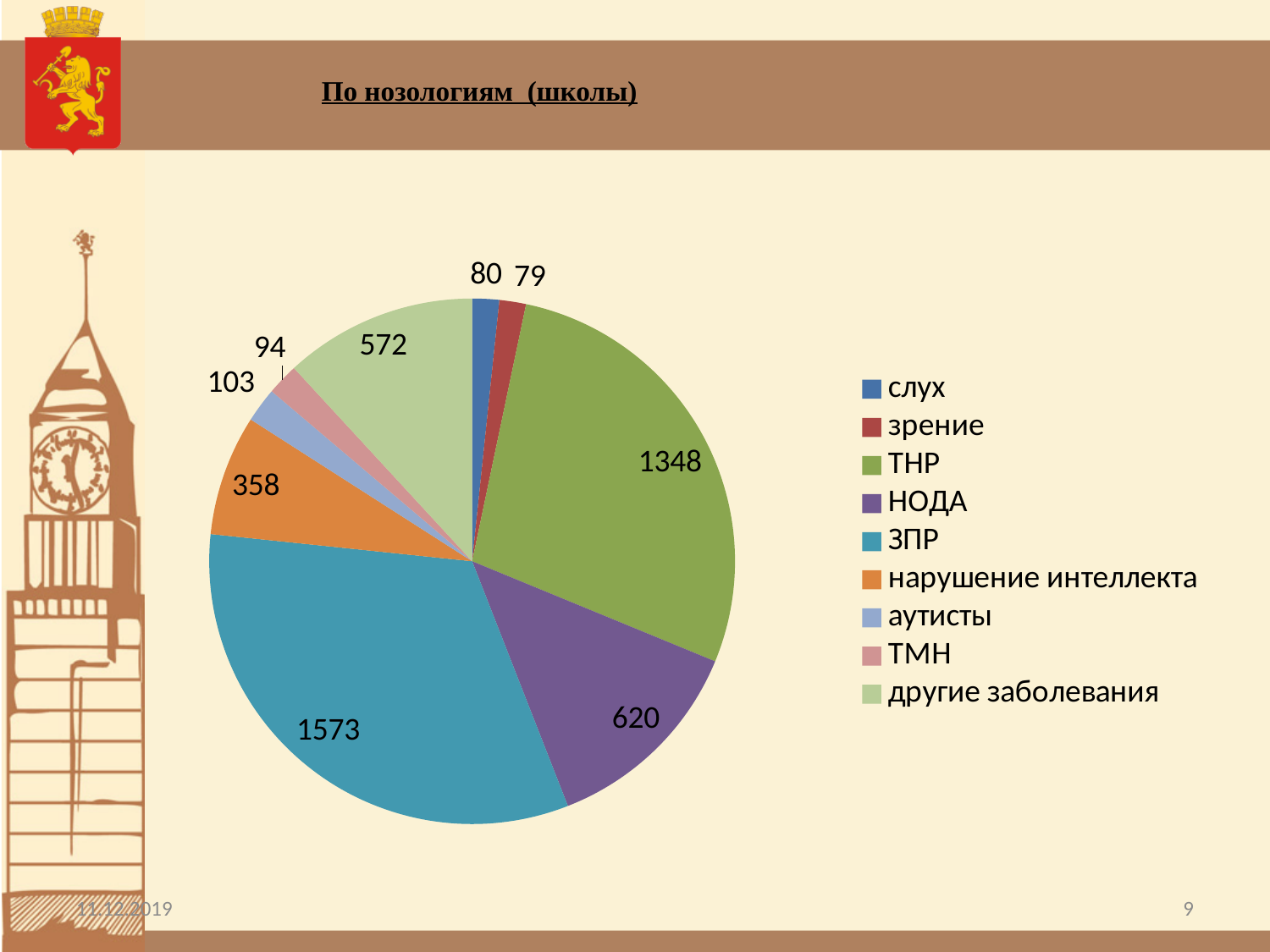
What colour is the slice for ТМН? pink Which is larger, the value for НОДА or the value for другие заболевания? НОДА What is the value for аутисты? 103 What is the value for нарушение интеллекта? 358 What is the value for ТНР? 1348 What is the value for ЗПР? 1573 What is the title of the slide above the chart? По нозологиям (школы) How many categories does the pie chart have? 9 Which category has the largest slice of the pie? ЗПР What is the difference between the values for ЗПР and ТНР? 225 Which category has the smallest value? зрение What type of chart is shown on the slide? pie chart